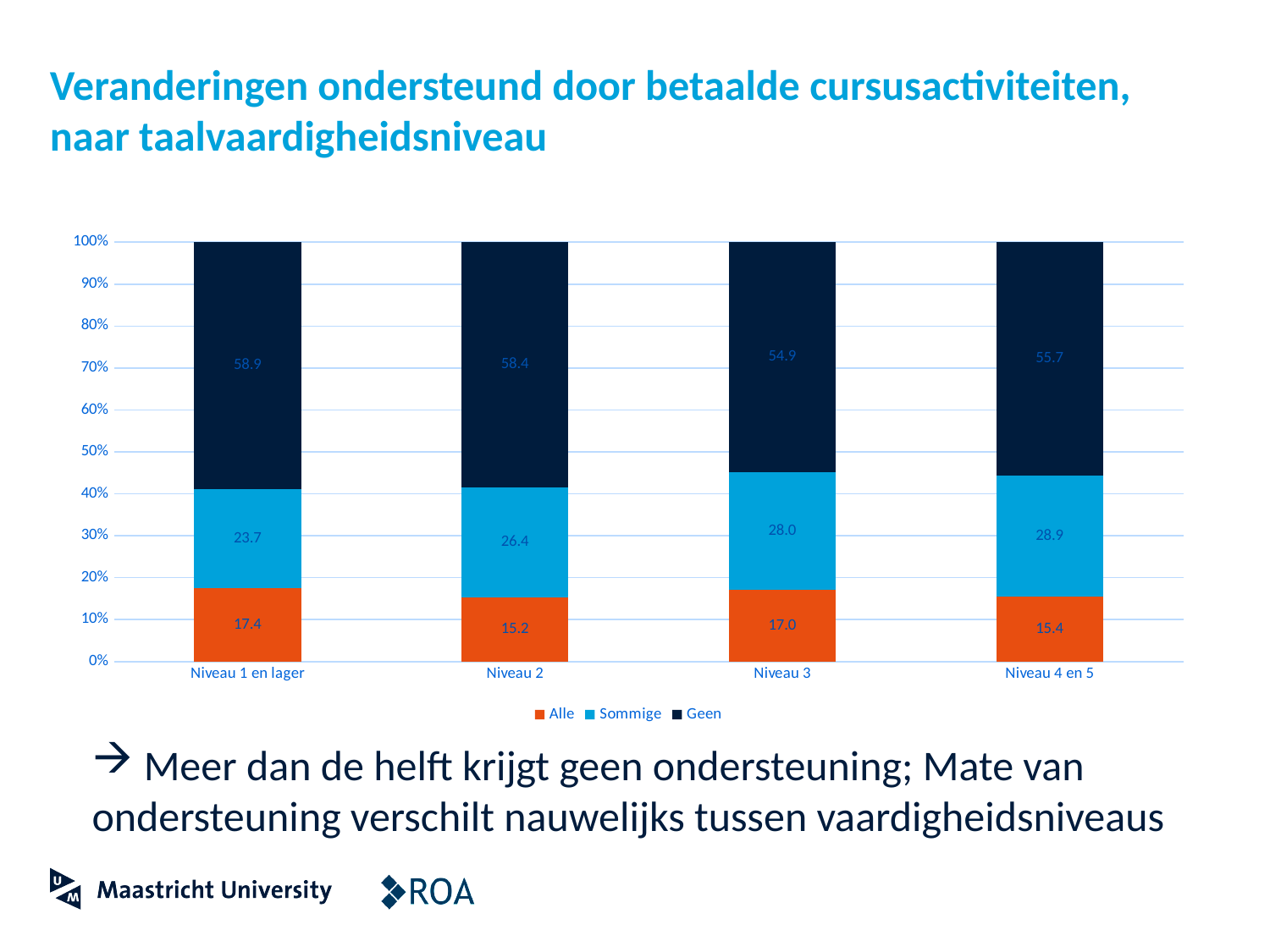
Which series is shown in orange in the legend? Alle Which category has the highest value for 'Geen'? Niveau 1 en lager What is the value for 'Alle' at Niveau 1 en lager? 17.4 How many categories are shown on the x axis? 4 Do the 'Sommige' values rise or fall from Niveau 1 en lager to Niveau 4 en 5? Rise What kind of chart is shown on the slide? Stacked bar chart What is the value for 'Sommige' at Niveau 4 en 5? 28.9 What is the difference between the 'Sommige' values for Niveau 3 and Niveau 1 en lager? 4.3 Which is larger: the 'Geen' value for Niveau 2 or for Niveau 4 en 5? Niveau 2 Which category has the lowest value for 'Alle'? Niveau 2 How many series does the legend list? 3 What is the value for 'Geen' at Niveau 3? 54.9